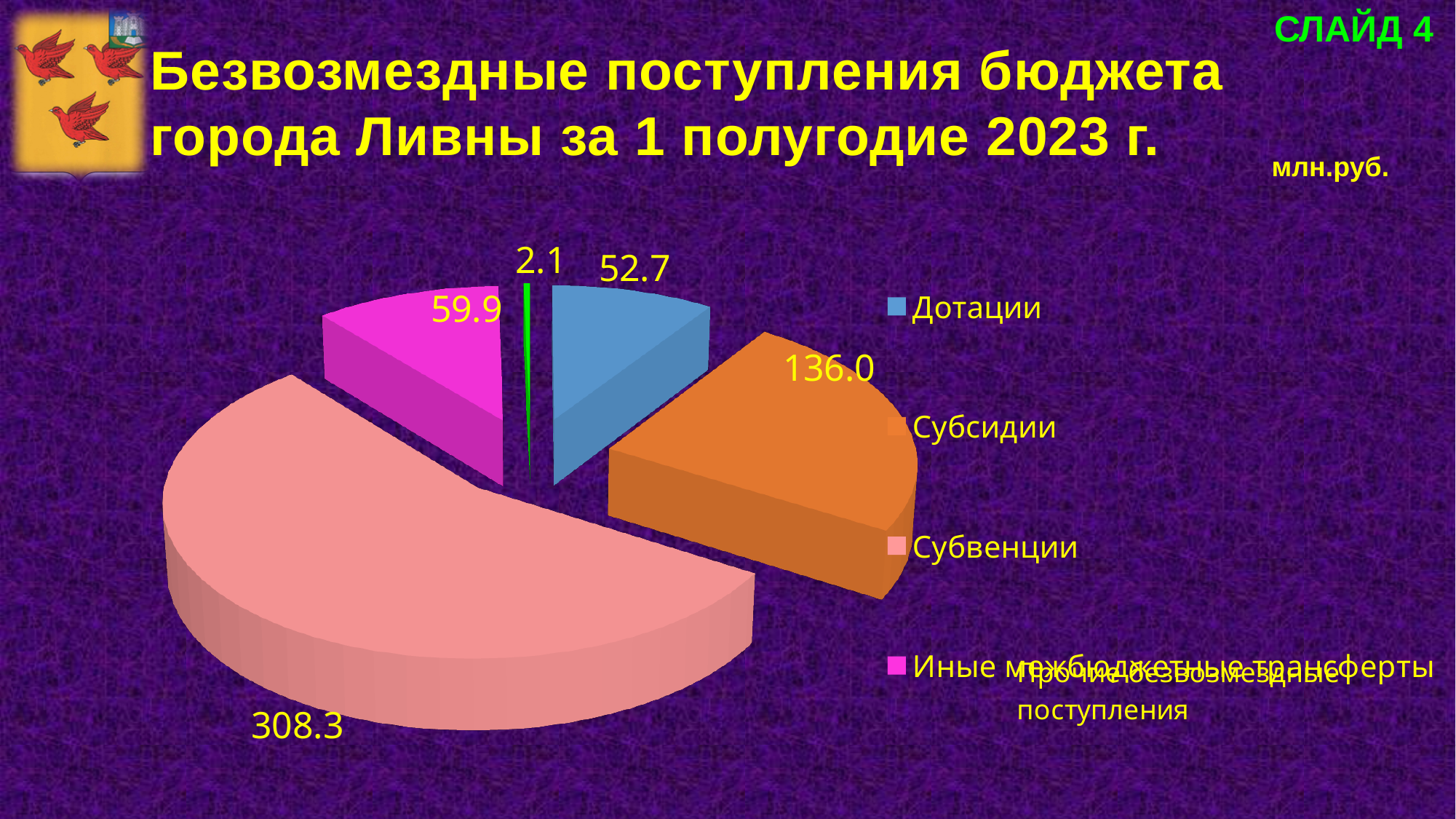
What is the value for Дотации? 52.7 How many slices does the pie chart have? 5 What type of chart is shown on the slide? Pie chart What is the value for Иные межбюджетные трансферты? 59.9 What is the value for Субсидии? 136.0 What is the value of the smallest slice of the pie? 2.1 Which category has the largest slice of the pie? Субвенции In what units are the values on the chart given? млн.руб. What is the difference between the values for Субвенции and Субсидии? 172.3 What is the difference between the values for Субсидии and Дотации? 83.3 What is the value for Субвенции? 308.3 Which is larger, Иные межбюджетные трансферты or Дотации? Иные межбюджетные трансферты